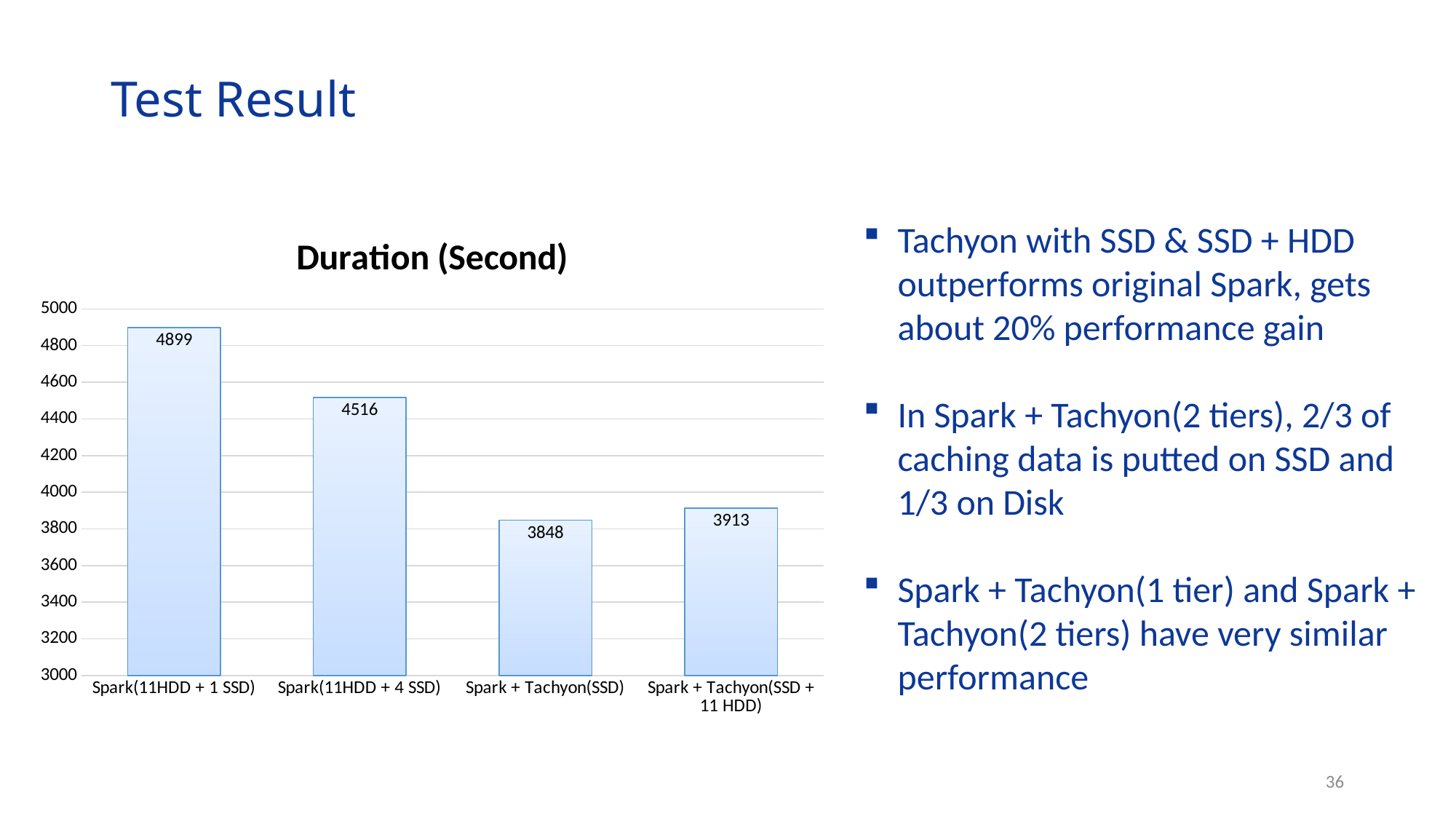
What is the difference in duration between Spark + Tachyon(SSD + 11 HDD) and Spark + Tachyon(SSD)? 65 What is the duration for Spark + Tachyon(SSD + 11 HDD)? 3913 Is the value for Spark(11HDD + 4 SSD) greater or less than 4400? greater Which configuration has the highest duration? Spark(11HDD + 1 SSD) What is the duration for Spark(11HDD + 1 SSD)? 4899 What is the difference in duration between Spark(11HDD + 1 SSD) and Spark(11HDD + 4 SSD)? 383 Which has a larger duration, Spark(11HDD + 4 SSD) or Spark + Tachyon(SSD + 11 HDD)? Spark(11HDD + 4 SSD) What is the duration for Spark + Tachyon(SSD)? 3848 What type of chart is shown on the slide? Bar chart How many configurations are shown in the chart? 4 What is the title of the chart? Duration (Second) Which configuration has the lowest duration? Spark + Tachyon(SSD)